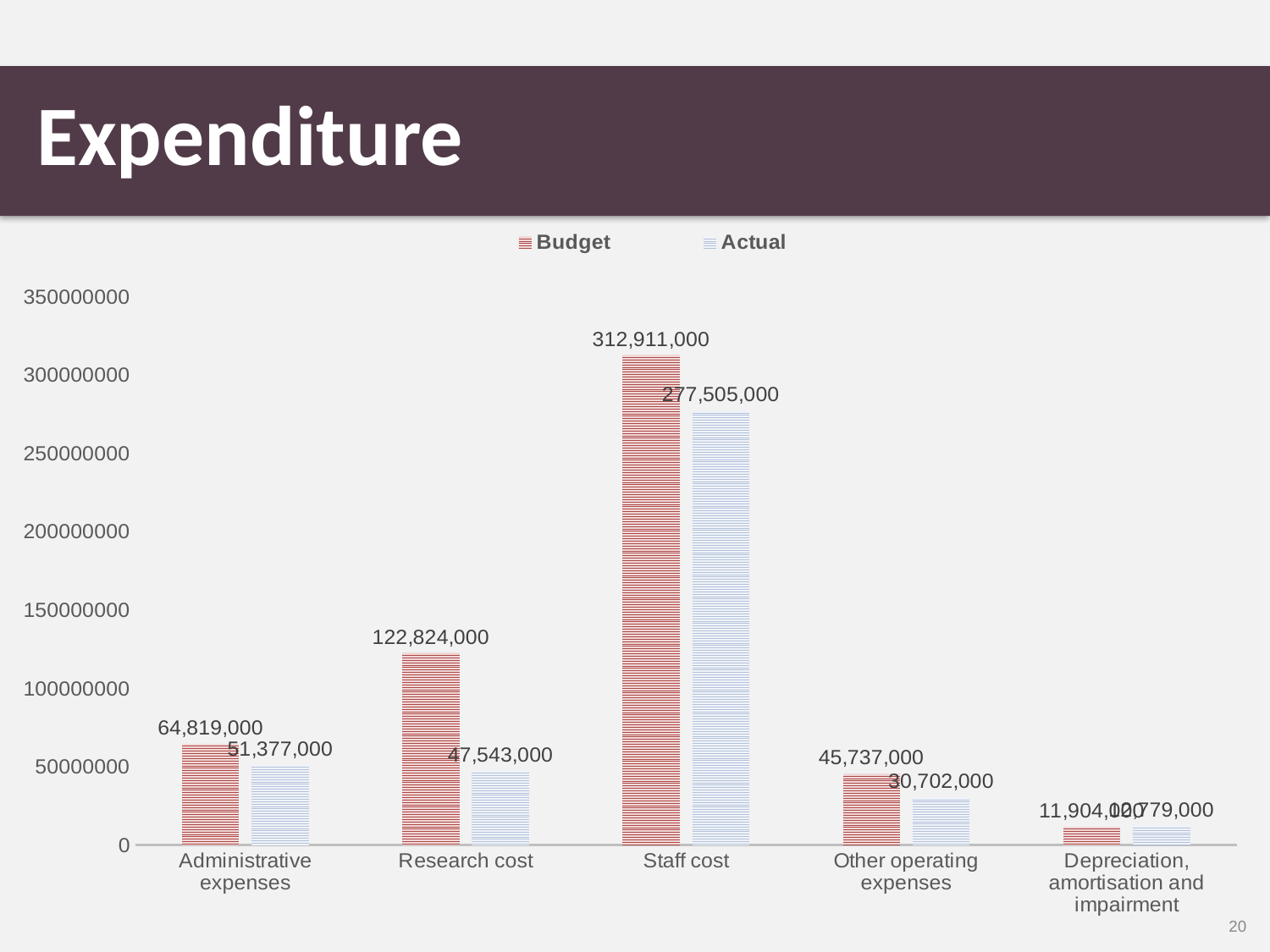
Which category has the lowest Actual value? Depreciation, amortisation and impairment What is the Budget value for Staff cost? 312,911,000 What is the Actual value for Other operating expenses? 30,702,000 Which category has the highest Budget value? Staff cost Is the Actual value for Staff cost greater or less than 250000000? greater How many expenditure categories are shown on the x axis? 5 What is the Actual value for Research cost? 47,543,000 What is the difference between the Budget and Actual values for Staff cost? 35,406,000 What is the Budget value for Administrative expenses? 64,819,000 How many series does the legend list? 2 Which is larger for Administrative expenses, the Budget or the Actual value? Budget What is the difference between the Budget and Actual values for Research cost? 75,281,000